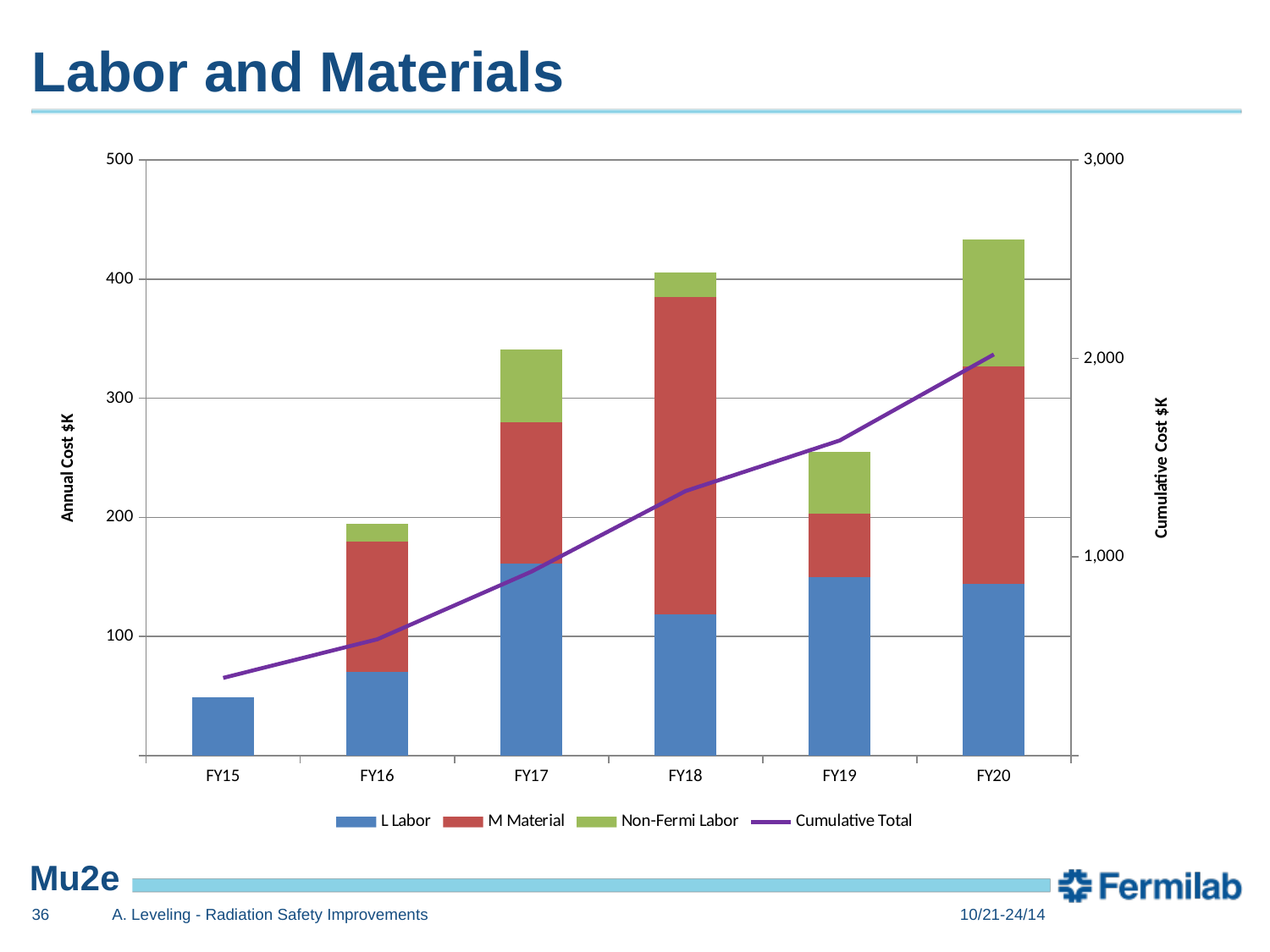
Is the L Labor value for FY15 greater or less than 100? less Which fiscal year has the tallest stacked bar for annual cost? FY20 How many series does the chart's legend list? 4 Is the total annual cost for FY19 greater or less than 300? less Is the Cumulative Total for FY16 greater or less than 1,000? less Does the Cumulative Total line rise or fall from FY15 to FY20? rise What kind of chart is shown on the slide? combination bar and line chart Which is larger, the L Labor value for FY17 or for FY18? FY17 How many fiscal years are shown on the x axis of the chart? 6 Which fiscal year has the shortest stacked bar for annual cost? FY15 What is the title of the right-hand vertical axis? Cumulative Cost $K